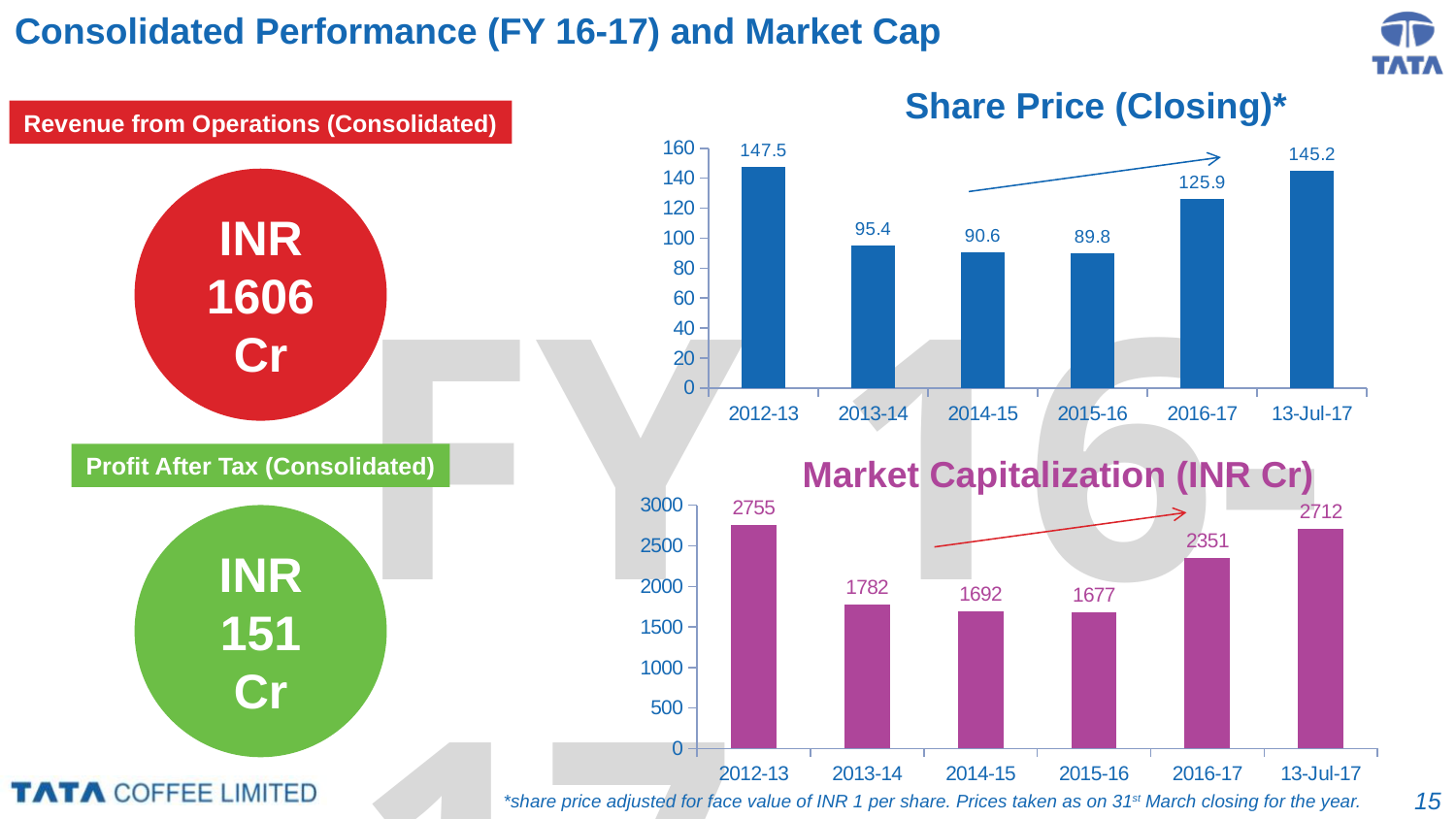
In the Share Price (Closing) chart, what is the difference between the values for 2016-17 and 2015-16? 36.1 In the Share Price (Closing) chart, what is the value for 2012-13? 147.5 In the Share Price (Closing) chart, how many categories are shown on the x axis? 6 In the Market Capitalization (INR Cr) chart, which category has the highest value? 2012-13 In the Share Price (Closing) chart, do the values rise or fall from 2015-16 to 13-Jul-17? Rise In the Share Price (Closing) chart, what is the value for 13-Jul-17? 145.2 In the Market Capitalization (INR Cr) chart, what is the difference between the values for 2012-13 and 13-Jul-17? 43 In the Share Price (Closing) chart, which category has the lowest value? 2015-16 In the Market Capitalization (INR Cr) chart, what is the value for 2016-17? 2351 What kind of chart is the Market Capitalization (INR Cr) chart? Bar chart In the Market Capitalization (INR Cr) chart, which is larger, the value for 2013-14 or the value for 2014-15? 2013-14 In the Market Capitalization (INR Cr) chart, which category has the lowest value? 2015-16